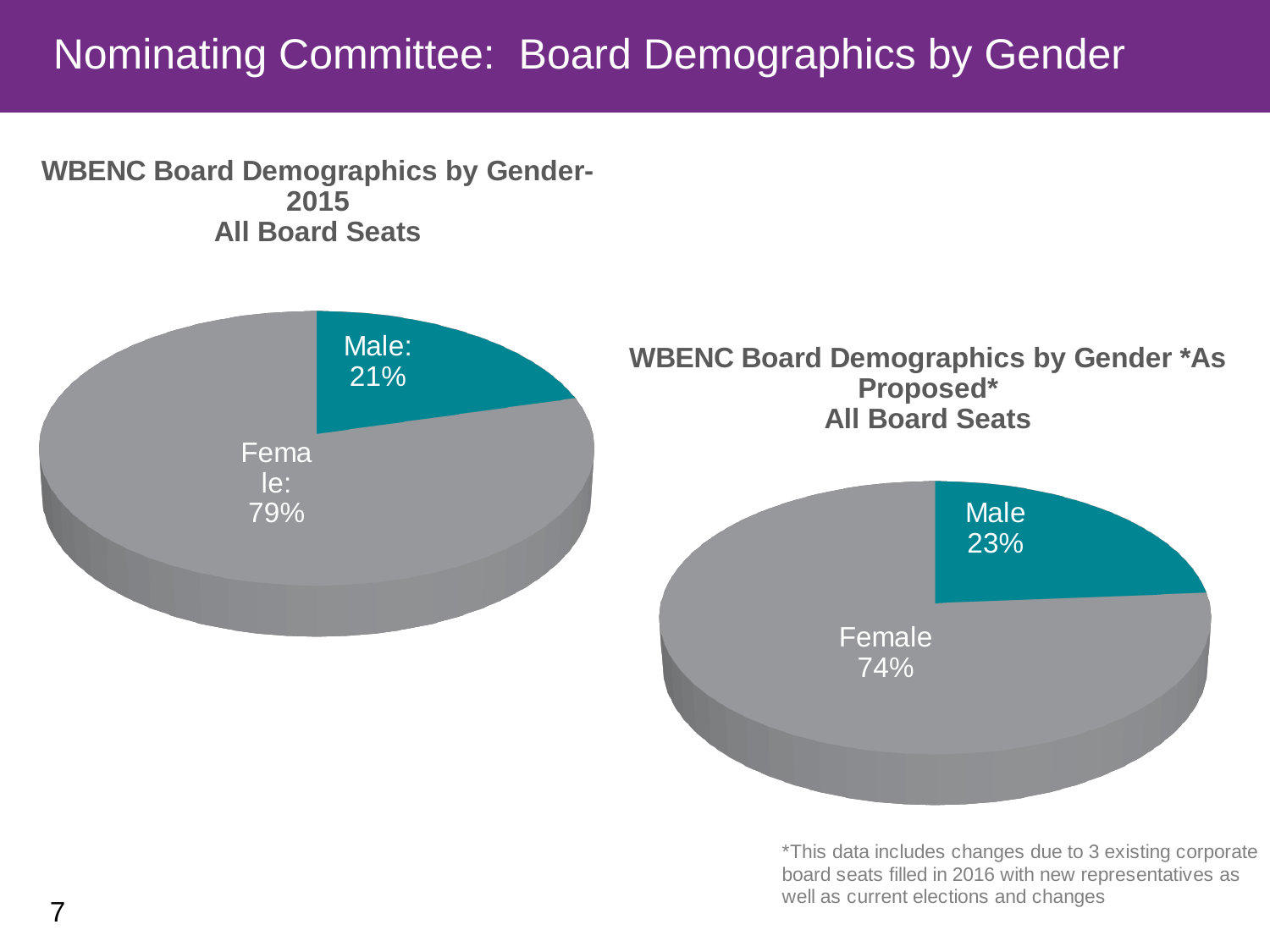
In the As Proposed All Board Seats pie chart, which gender has the smallest share? Male In the 2015 All Board Seats pie chart, which gender has the largest share? Female How many slices does the As Proposed All Board Seats pie chart have? 2 In the As Proposed All Board Seats pie chart, what share of board seats is Male? 23% In the As Proposed All Board Seats pie chart, what is the difference between the Female and Male shares? 51% In the 2015 All Board Seats pie chart, what share of board seats is Female? 79% Is the Male share larger in the 2015 chart or in the As Proposed chart? As Proposed What kind of chart is used for the 2015 All Board Seats data? Pie chart In the 2015 All Board Seats pie chart, what is the difference between the Female and Male shares? 58% In the 2015 All Board Seats pie chart, what share of board seats is Male? 21% In the 2015 All Board Seats pie chart, what colour is the Male slice? Teal In the As Proposed All Board Seats pie chart, what share of board seats is Female? 74%